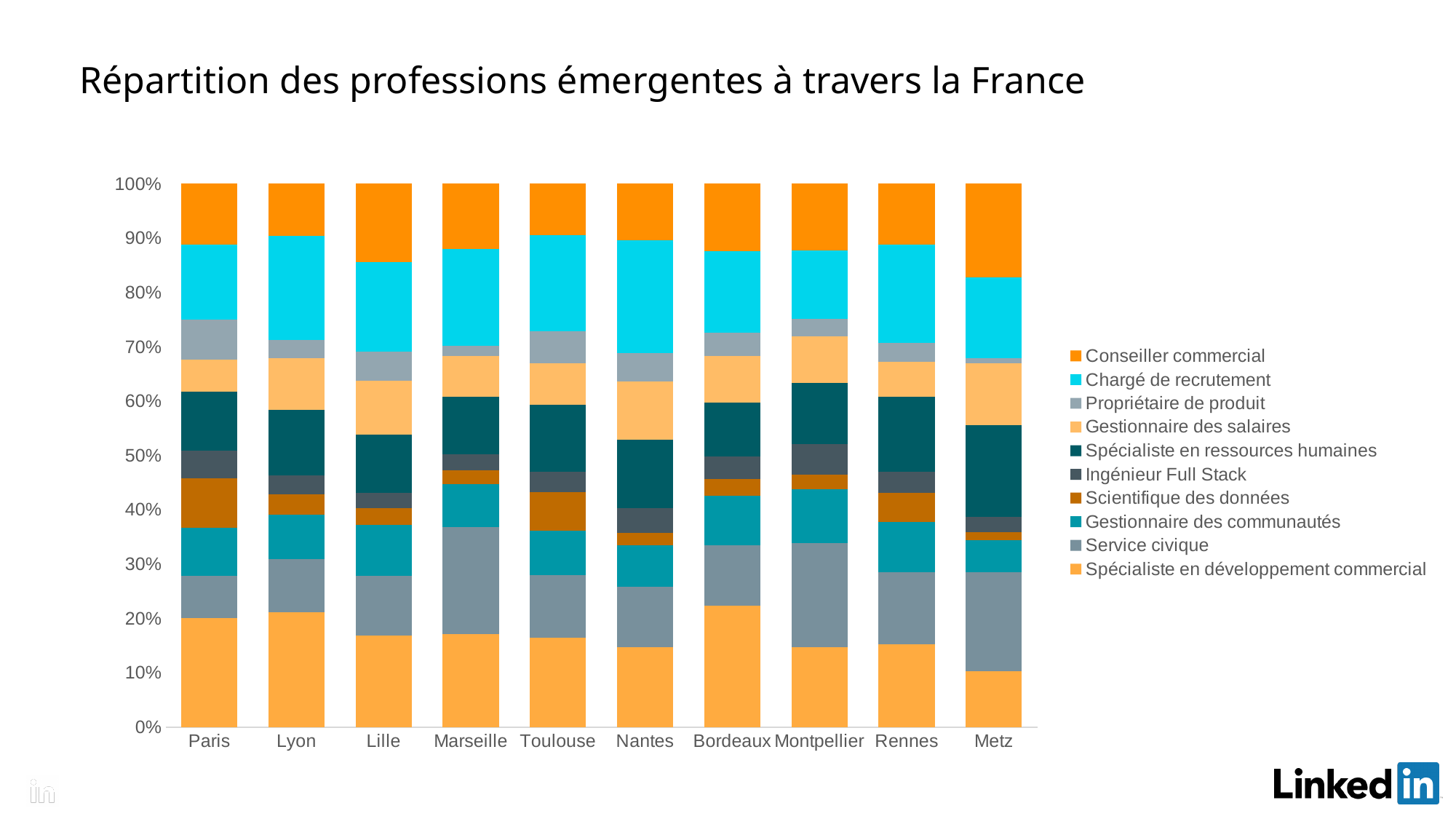
What is the total of each stacked bar in the chart? 100% How many cities are shown on the x axis of the chart? 10 What is the title of the chart? Répartition des professions émergentes à travers la France Which city has the larger share for Spécialiste en développement commercial, Paris or Metz? Paris Which series is shown at the bottom of each stacked bar? Spécialiste en développement commercial Which city has the smallest share for Spécialiste en développement commercial? Metz Which city has the largest share for Conseiller commercial? Metz Which city has the larger share for Conseiller commercial, Metz or Lyon? Metz Is the share for Spécialiste en développement commercial in Bordeaux greater or less than 20%? greater How many series does the legend list? 10 What kind of chart is shown on the slide? Stacked bar chart Is the share for Spécialiste en développement commercial in Metz greater or less than 15%? less